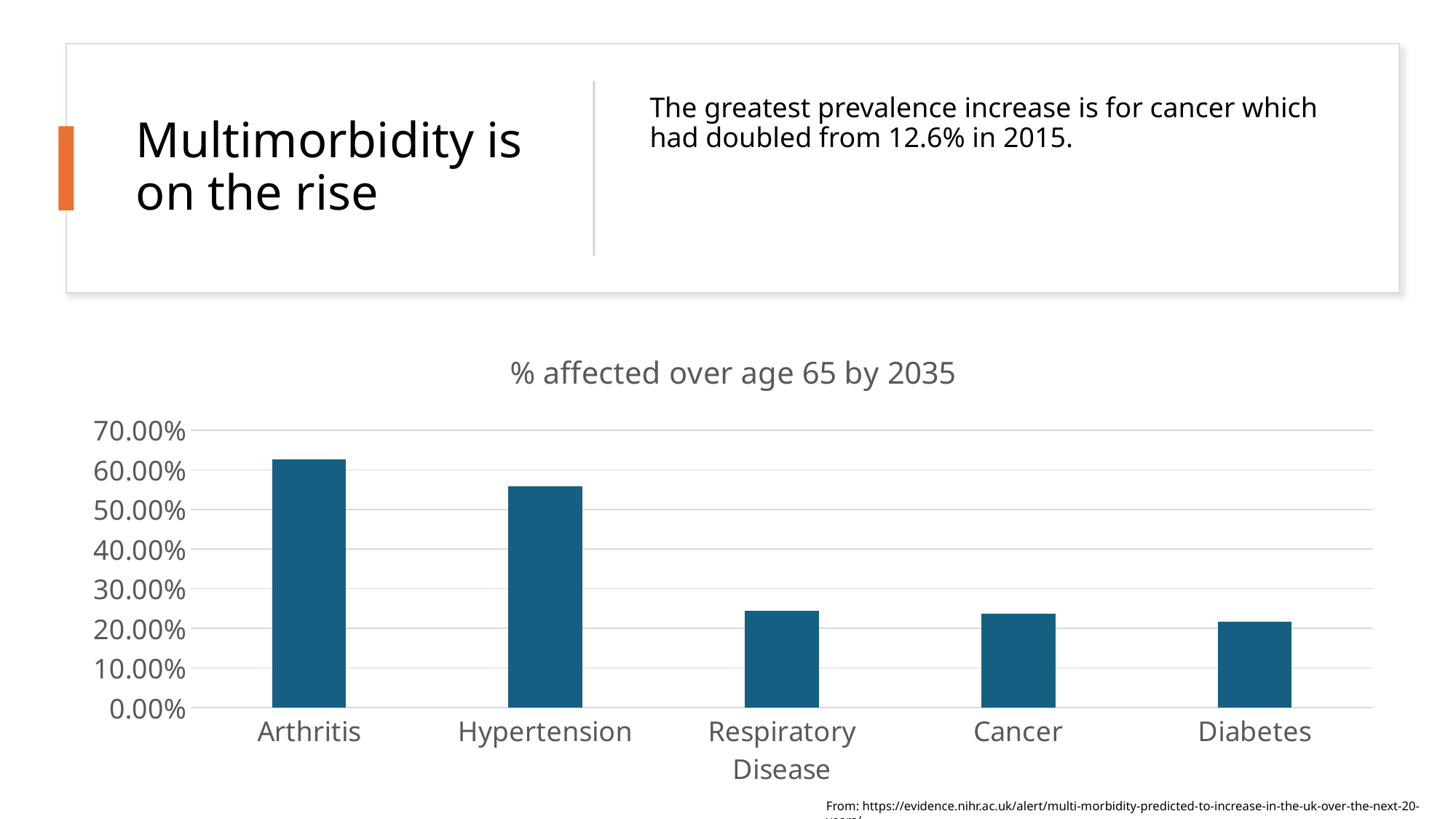
Is the value for Cancer greater or less than 20.00%? greater What is the title of the chart? % affected over age 65 by 2035 Is the value for Hypertension greater or less than 60.00%? less Is the value for Hypertension greater or less than 50.00%? greater Which is larger, the value for Hypertension or the value for Diabetes? Hypertension How many categories are shown on the x axis of the chart? 5 Which category has the highest value in the chart? Arthritis What kind of chart is shown on the slide? bar chart Which is larger, the value for Arthritis or the value for Hypertension? Arthritis